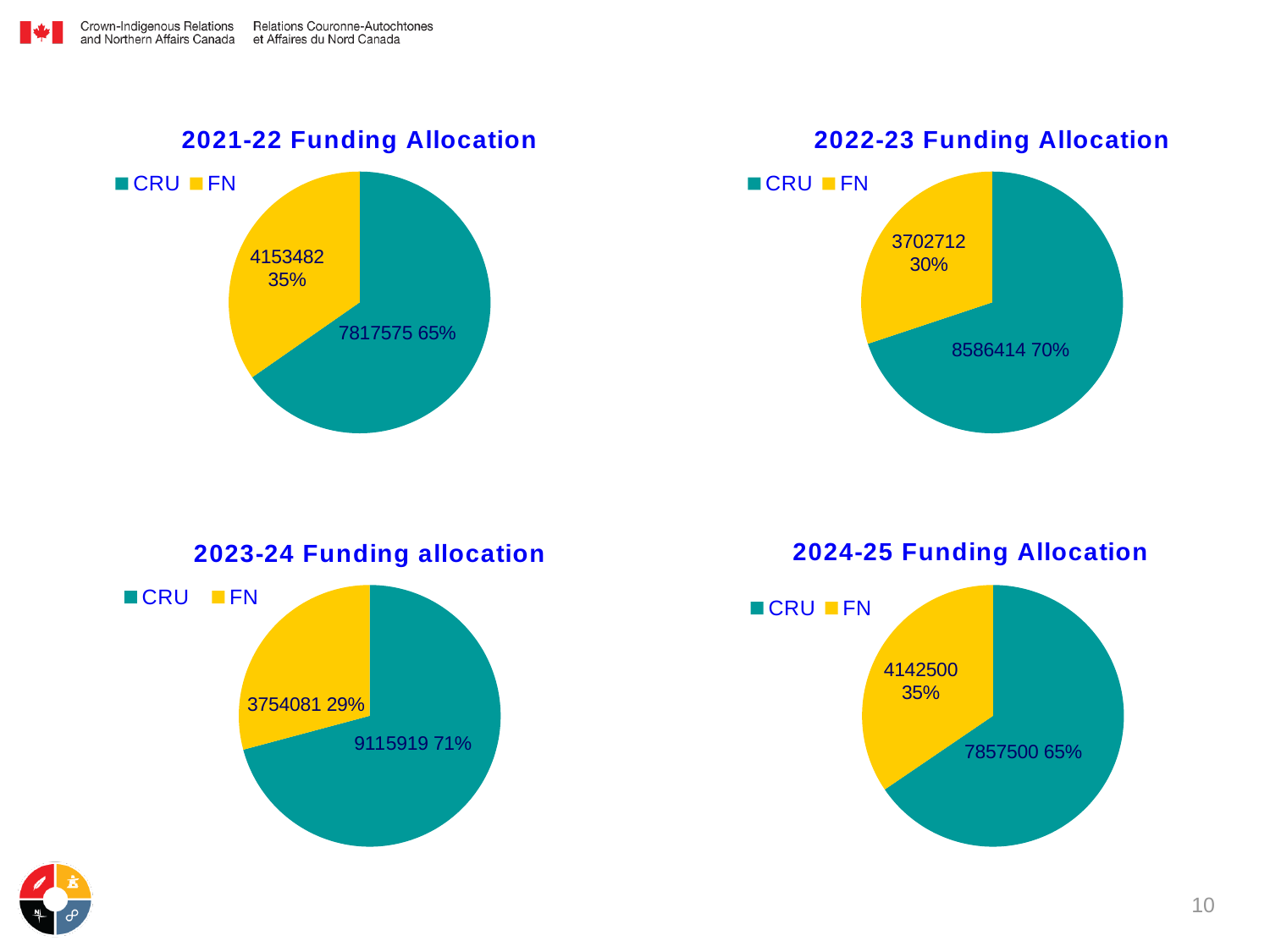
In the 2024-25 Funding Allocation chart, what is the difference between the CRU and FN values? 3715000 In the 2024-25 Funding Allocation chart, what value is shown for FN? 4142500 In the 2023-24 Funding allocation chart, which category has the smallest slice? FN What kind of chart is the 2022-23 Funding Allocation chart? Pie chart In the 2021-22 Funding Allocation chart, which category has the largest slice? CRU In the 2023-24 Funding allocation chart, what share of the pie does FN represent? 29% In the 2022-23 Funding Allocation chart, what share of the pie does CRU represent? 70% In the 2023-24 Funding allocation chart, what value is shown for CRU? 9115919 In the 2022-23 Funding Allocation chart, what value is shown for FN? 3702712 How many categories does the legend of the 2024-25 Funding Allocation chart list? 2 In the 2021-22 Funding Allocation chart, what value is shown for CRU? 7817575 In the 2021-22 Funding Allocation chart, what share of the pie does FN represent? 35%